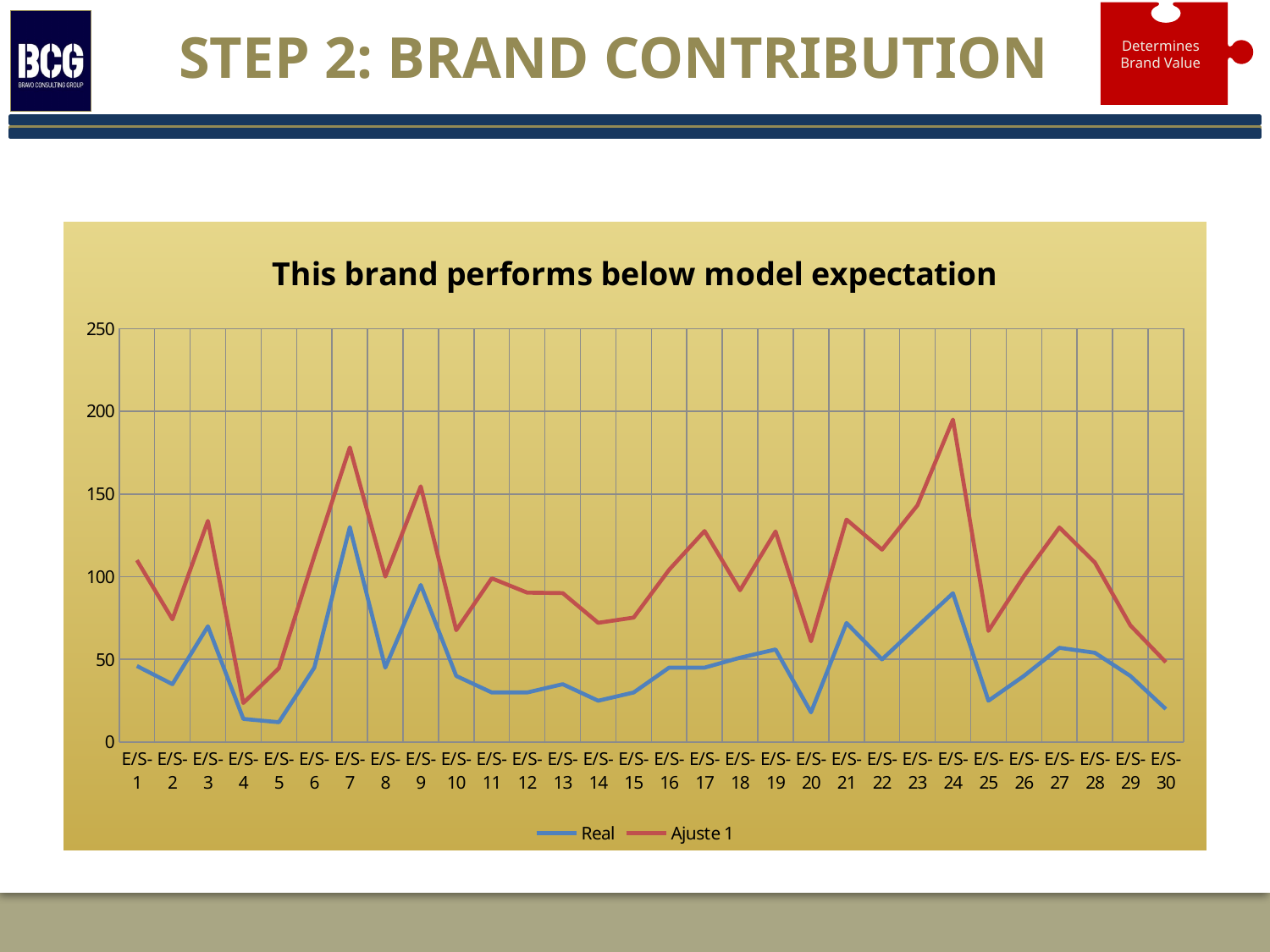
What kind of chart is shown on the slide? Line chart How many series does the legend list? 2 What is the title of the chart? This brand performs below model expectation Does the Ajuste 1 series rise or fall from E/S-4 to E/S-7? Rise At which x-axis category does the Ajuste 1 series reach its lowest value? E/S-4 Which colour is used for the Real series? Blue At which x-axis category does the Ajuste 1 series reach its highest value? E/S-24 At which x-axis category does the Real series reach its highest value? E/S-7 Is the value of Ajuste 1 at E/S-24 greater or less than 150? greater At E/S-9, which series has the larger value, Real or Ajuste 1? Ajuste 1 Is the value of Real at E/S-20 greater or less than 50? less How many points are plotted along the x axis for each series? 30